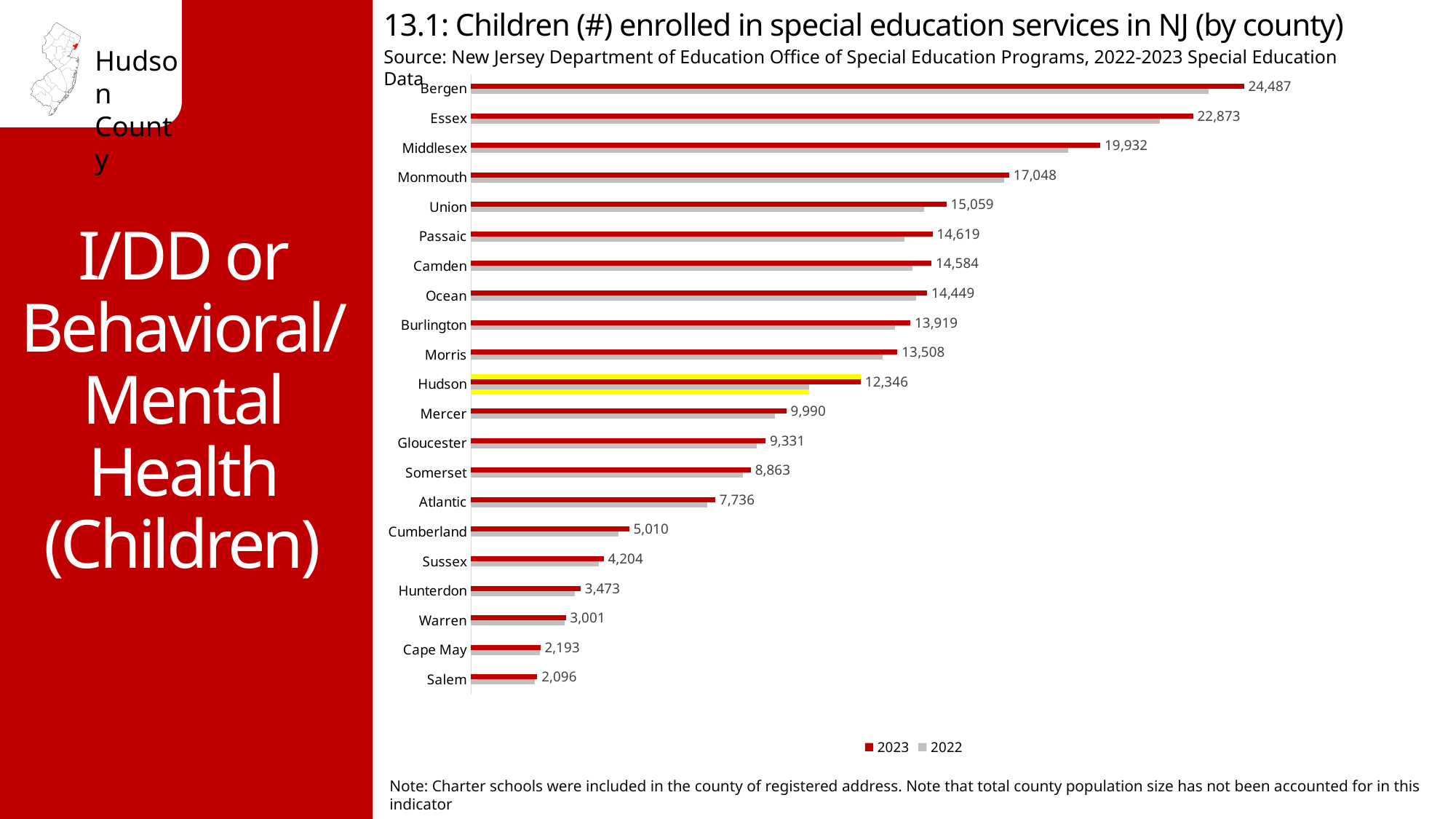
Which county's bars are highlighted in yellow on the chart? Hudson How many series does the legend list? 2 How many children were enrolled in special education services in Bergen county in 2023? 24,487 Which county has the lowest 2023 value? Salem Which county has the highest 2023 value? Bergen How many counties are shown in the chart? 21 Which county has a larger 2023 value, Union or Mercer? Union What is the difference between the 2023 values for Essex and Middlesex? 2,941 What is the difference between the 2023 values for Bergen and Hudson? 12,141 What is the 2023 value for Hudson county? 12,346 What is the 2023 value shown for Cumberland county? 5,010 What kind of chart is shown on the slide? Bar chart